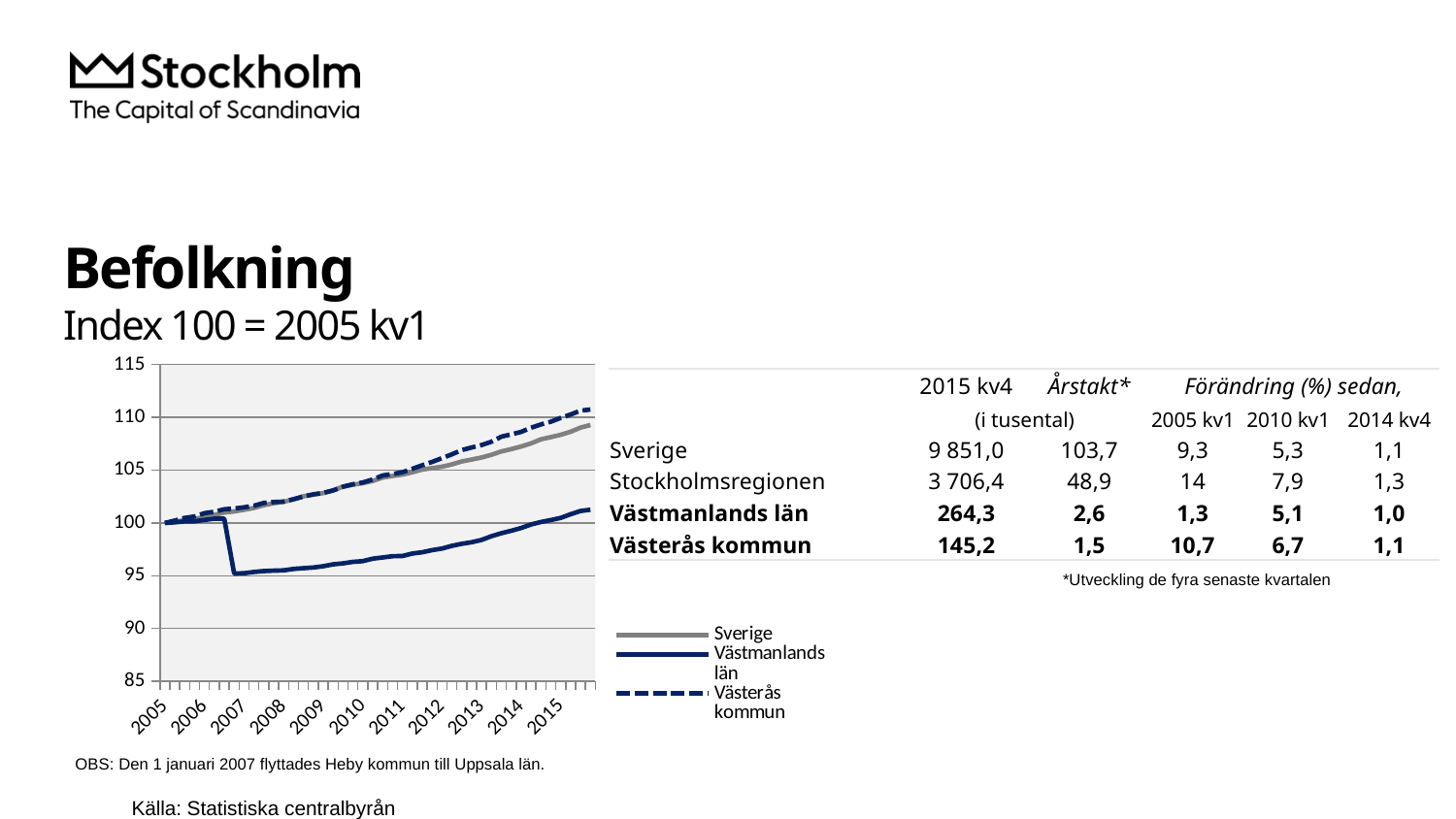
How many year labels are shown on the chart's x axis? 11 Which series has the lowest value at the end of 2015? Västmanlands län Is the value for Västerås kommun at the end of 2015 greater or less than 105? greater What kind of chart is shown on the slide? line chart Does the Sverige series rise or fall from 2005 to 2015? rise Is the value for Västmanlands län in 2010 greater or less than 100? less What is the highest value shown on the chart's y axis? 115 Which series are listed in the chart's legend? Sverige, Västmanlands län, Västerås kommun Is the value for Sverige at the end of 2015 greater or less than 105? greater How many series does the chart's legend list? 3 At the end of 2015, which is higher: Västerås kommun or Västmanlands län? Västerås kommun